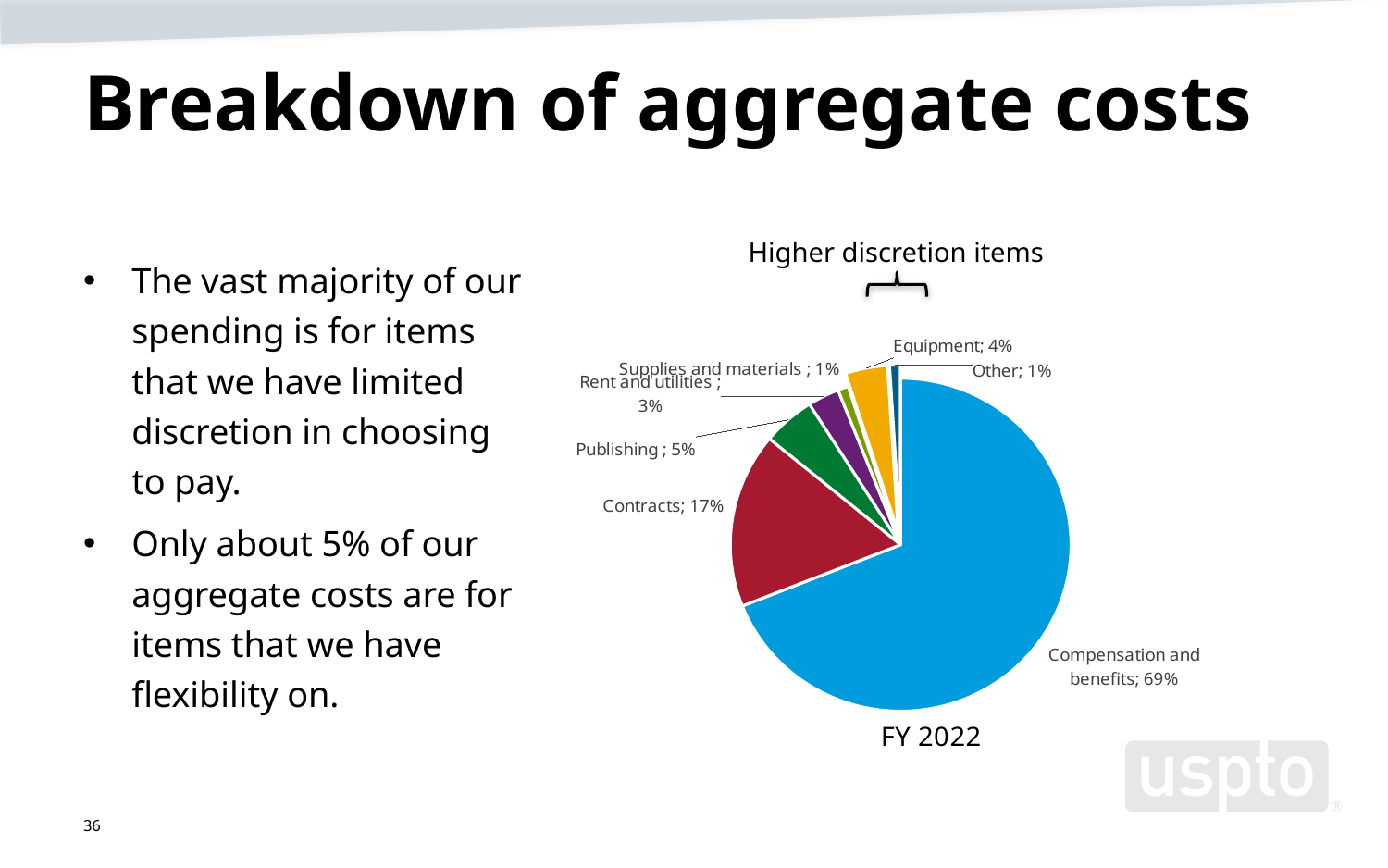
What share of aggregate costs is Rent and utilities? 3% What share of aggregate costs is Contracts? 17% What share of aggregate costs is Publishing? 5% What label is shown above the bracket at the top of the pie chart? Higher discretion items What fiscal year does the pie chart cover, according to the label below it? FY 2022 Which category has the largest share of the pie? Compensation and benefits What type of chart is shown on the slide? pie chart What is the difference between the Compensation and benefits share and the Contracts share? 52% What share of aggregate costs is Compensation and benefits? 69% What share of aggregate costs is Equipment? 4% How many slices does the pie chart have? 7 Which is larger, the share for Publishing or the share for Equipment? Publishing